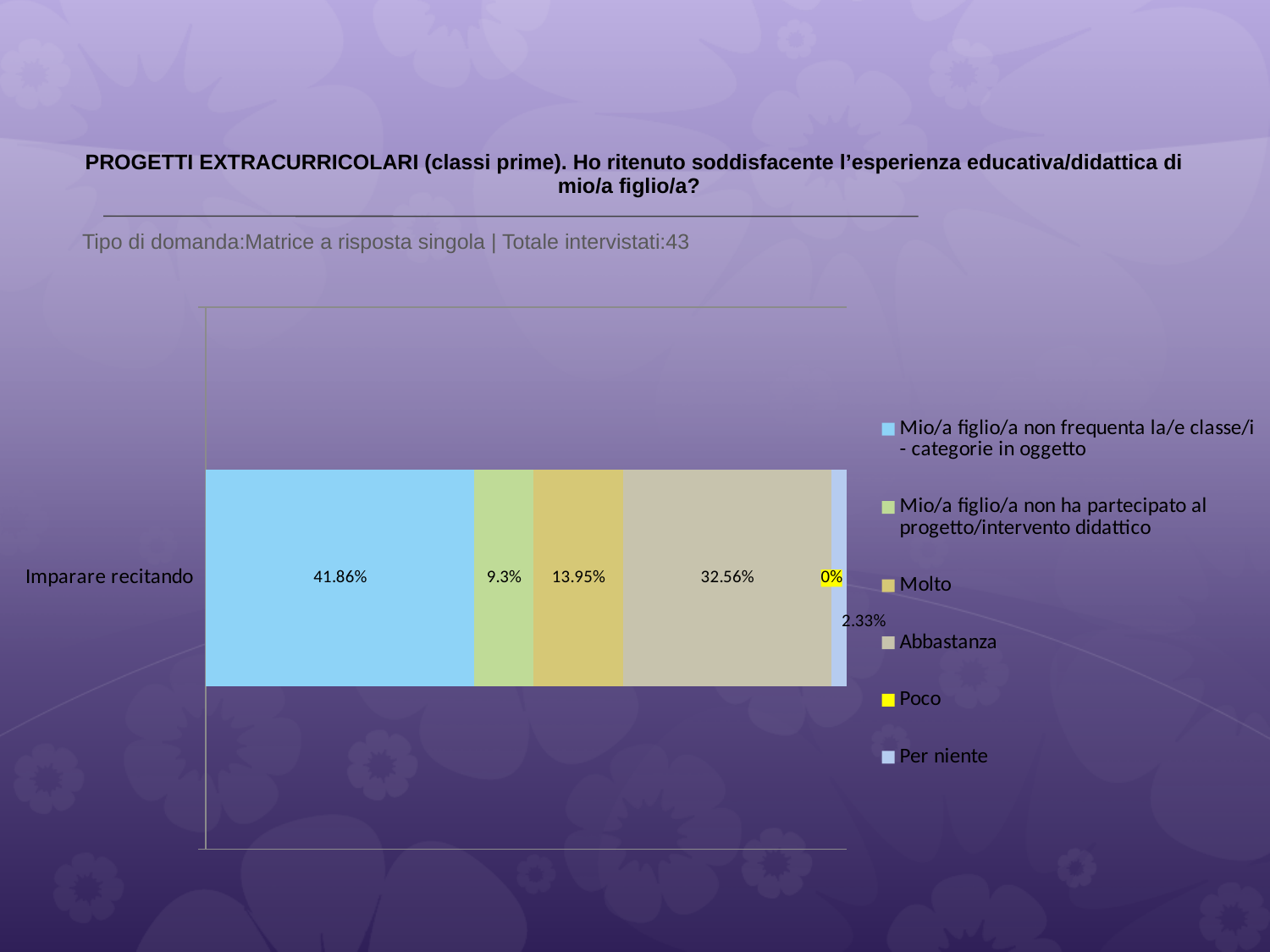
What is the value for "Per niente" for Imparare recitando? 2.33% How many categories are plotted on the chart? 1 What is the value for "Abbastanza" for Imparare recitando? 32.56% What kind of chart is shown on the slide? stacked bar chart Which series has the highest value for Imparare recitando? Mio/a figlio/a non frequenta la/e classe/i - categorie in oggetto What is the difference between the "Abbastanza" and "Molto" values for Imparare recitando? 18.61% How many series does the legend list? 6 What is the value for "Molto" for Imparare recitando? 13.95% Which series has the lowest value for Imparare recitando? Poco What is the value for "Mio/a figlio/a non ha partecipato al progetto/intervento didattico" for Imparare recitando? 9.3% What is the value for "Poco" for Imparare recitando? 0% Which is larger for Imparare recitando, "Molto" or "Abbastanza"? Abbastanza